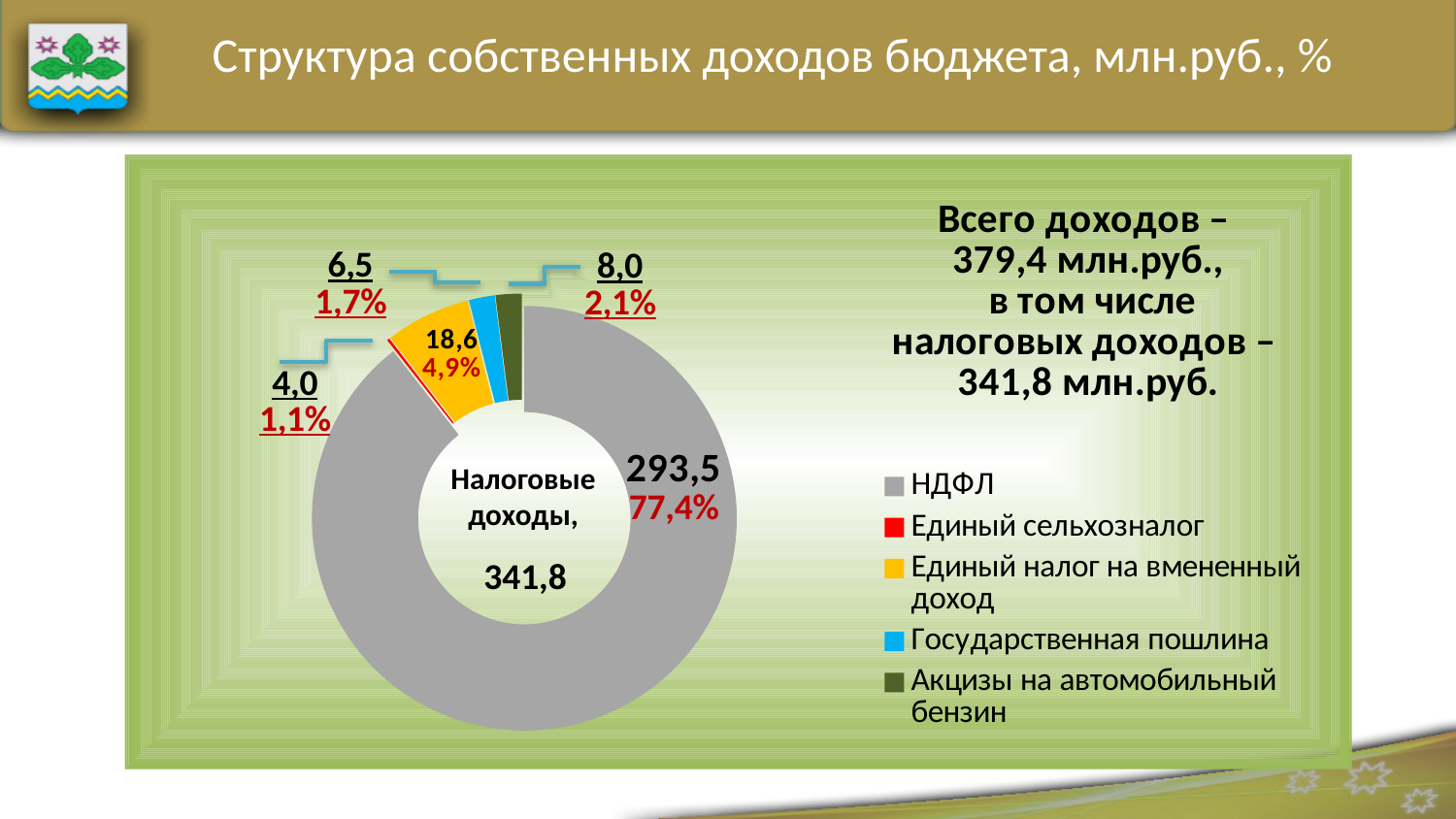
What is the value shown for Государственная пошлина? 6,5 What is the value shown for НДФЛ? 293,5 What total value is shown in the centre of the doughnut chart? 341,8 What is the value shown for Единый сельхозналог? 4,0 Which category has the smallest share of the chart? Единый сельхозналог What percentage share is shown for Акцизы на автомобильный бензин? 2,1% Which category has the largest share of the chart? НДФЛ What kind of chart is shown on the slide? Doughnut (pie) chart What percentage share is shown for Единый налог на вмененный доход? 4,9% How many categories does the legend of the chart list? 5 What is the value shown for Единый налог на вмененный доход? 18,6 What percentage share is shown for НДФЛ? 77,4%